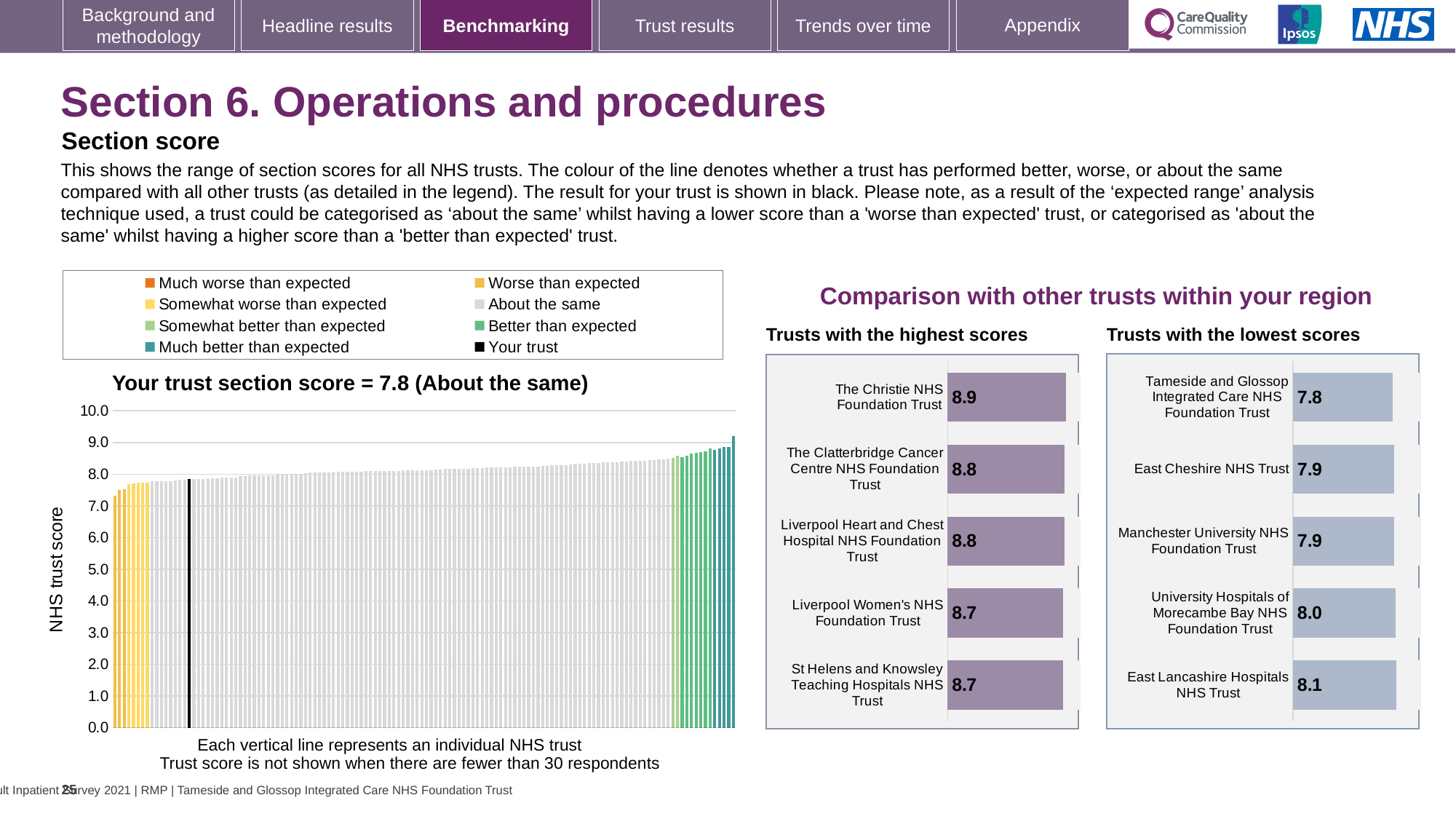
How many trusts are shown in the 'Trusts with the highest scores' chart? 5 In the 'Trusts with the highest scores' chart, what is the score for The Christie NHS Foundation Trust? 8.9 In the 'Trusts with the lowest scores' chart, what is the score for East Lancashire Hospitals NHS Trust? 8.1 According to the title of the left chart, what is your trust's section score? 7.8 In the 'Trusts with the lowest scores' chart, which has the higher score: University Hospitals of Morecambe Bay NHS Foundation Trust or East Cheshire NHS Trust? University Hospitals of Morecambe Bay NHS Foundation Trust In the 'Trusts with the lowest scores' chart, what is the difference between the scores of East Lancashire Hospitals NHS Trust and Tameside and Glossop Integrated Care NHS Foundation Trust? 0.3 In the 'Trusts with the highest scores' chart, what is the difference between the scores of The Christie NHS Foundation Trust and St Helens and Knowsley Teaching Hospitals NHS Trust? 0.2 In the 'Trusts with the highest scores' chart, which trust has the highest score? The Christie NHS Foundation Trust What type of chart is the 'Your trust section score' chart on the left? Bar chart In the 'Trusts with the lowest scores' chart, which trust has the lowest score? Tameside and Glossop Integrated Care NHS Foundation Trust How many entries does the legend above the 'Your trust section score' chart list? 8 In the 'Your trust section score' chart, do the trust scores rise or fall from left to right? Rise